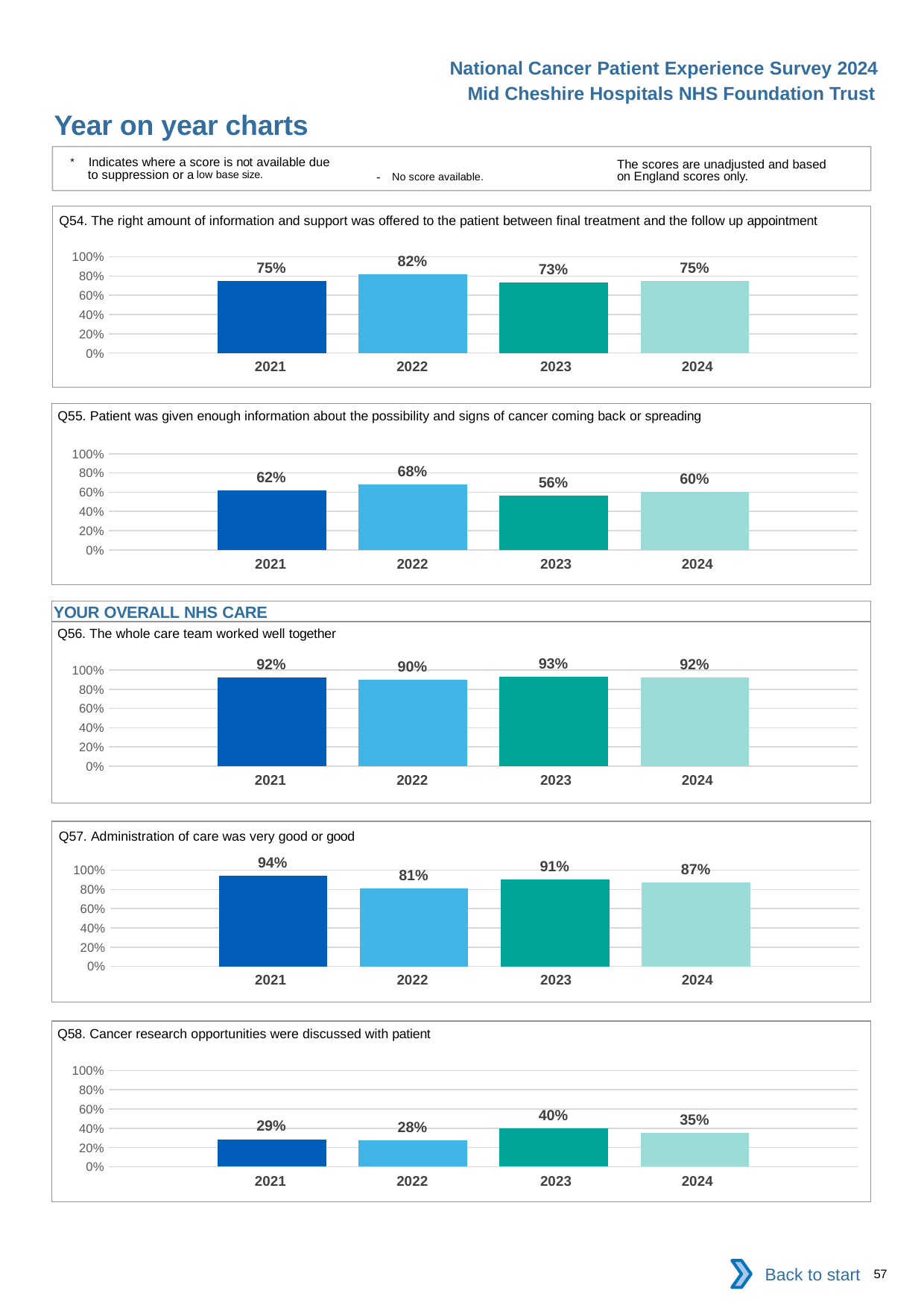
In the Q56 chart, what is the value for 2024? 92% In the Q58 chart, which is larger, the value for 2021 or the value for 2022? 2021 In the Q54 chart, what is the value for 2022? 82% In the Q58 chart, what is the value for 2023? 40% In the Q55 chart, which year has the lowest value? 2023 In the Q57 chart, what is the difference between the 2021 and 2022 values? 13 percentage points What kind of chart is the Q56 chart? Bar chart In the Q55 chart, what is the difference between the 2022 and 2024 values? 8 percentage points What is the title of the chart directly below the heading 'YOUR OVERALL NHS CARE'? Q56. The whole care team worked well together How many years are shown in the Q54 chart? 4 In the Q57 chart, which year has the highest value? 2021 In the Q58 chart, is the value for 2024 greater or less than 40%? less